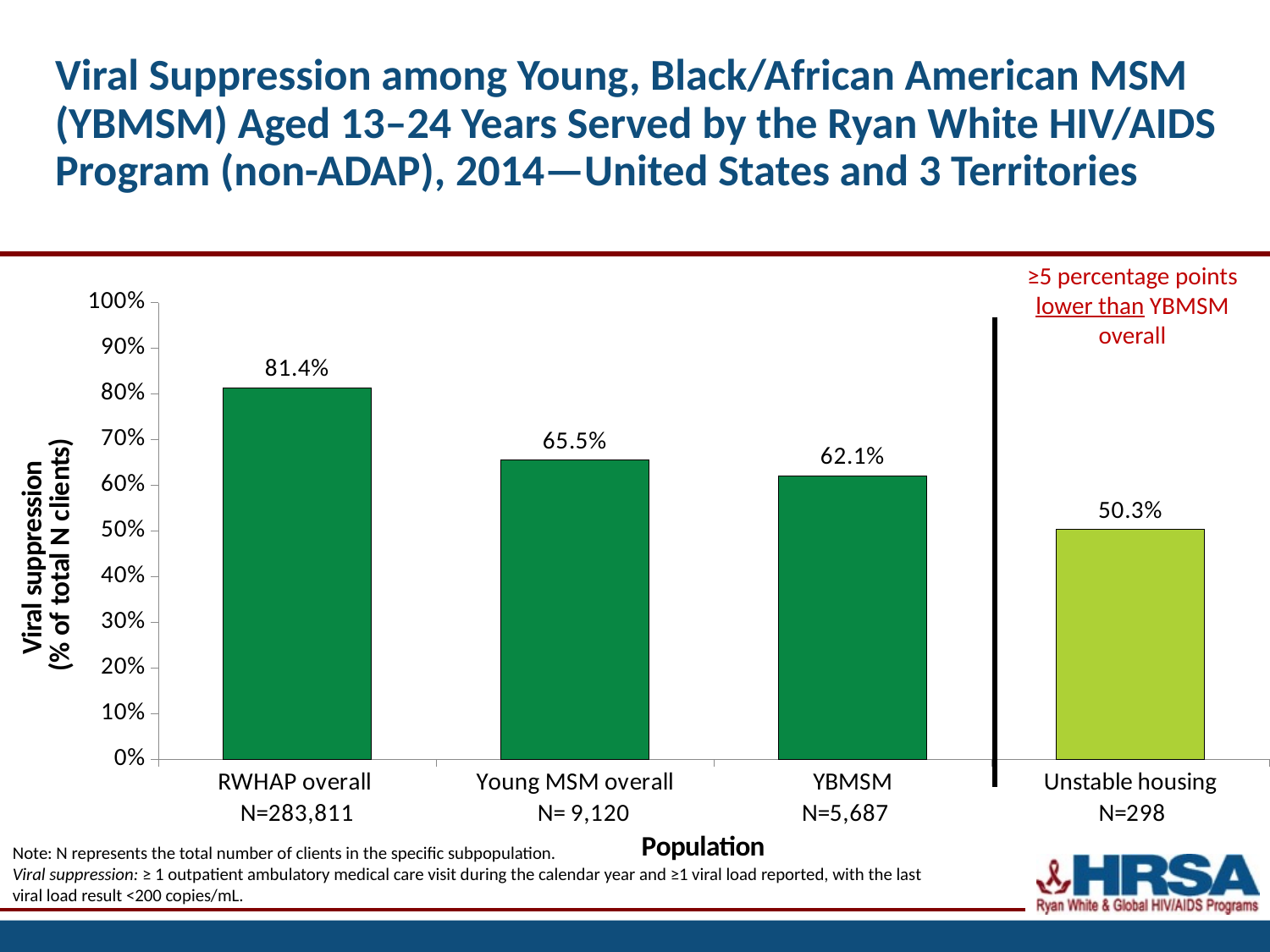
Which has a higher viral suppression value, Young MSM overall or YBMSM? Young MSM overall What is the viral suppression value for YBMSM? 62.1% Which population has the highest viral suppression? RWHAP overall What is the viral suppression value for RWHAP overall? 81.4% What is the difference in viral suppression between YBMSM and the Unstable housing group? 11.8 percentage points What kind of chart is shown on the slide? Bar chart How many populations are shown in the chart? 4 Which population has the lowest viral suppression? Unstable housing What is the N (number of clients) shown for the YBMSM population? N=5,687 What is the difference in viral suppression between RWHAP overall and YBMSM? 19.3 percentage points What is the viral suppression value for Young MSM overall? 65.5% What is the viral suppression value for the Unstable housing group? 50.3%